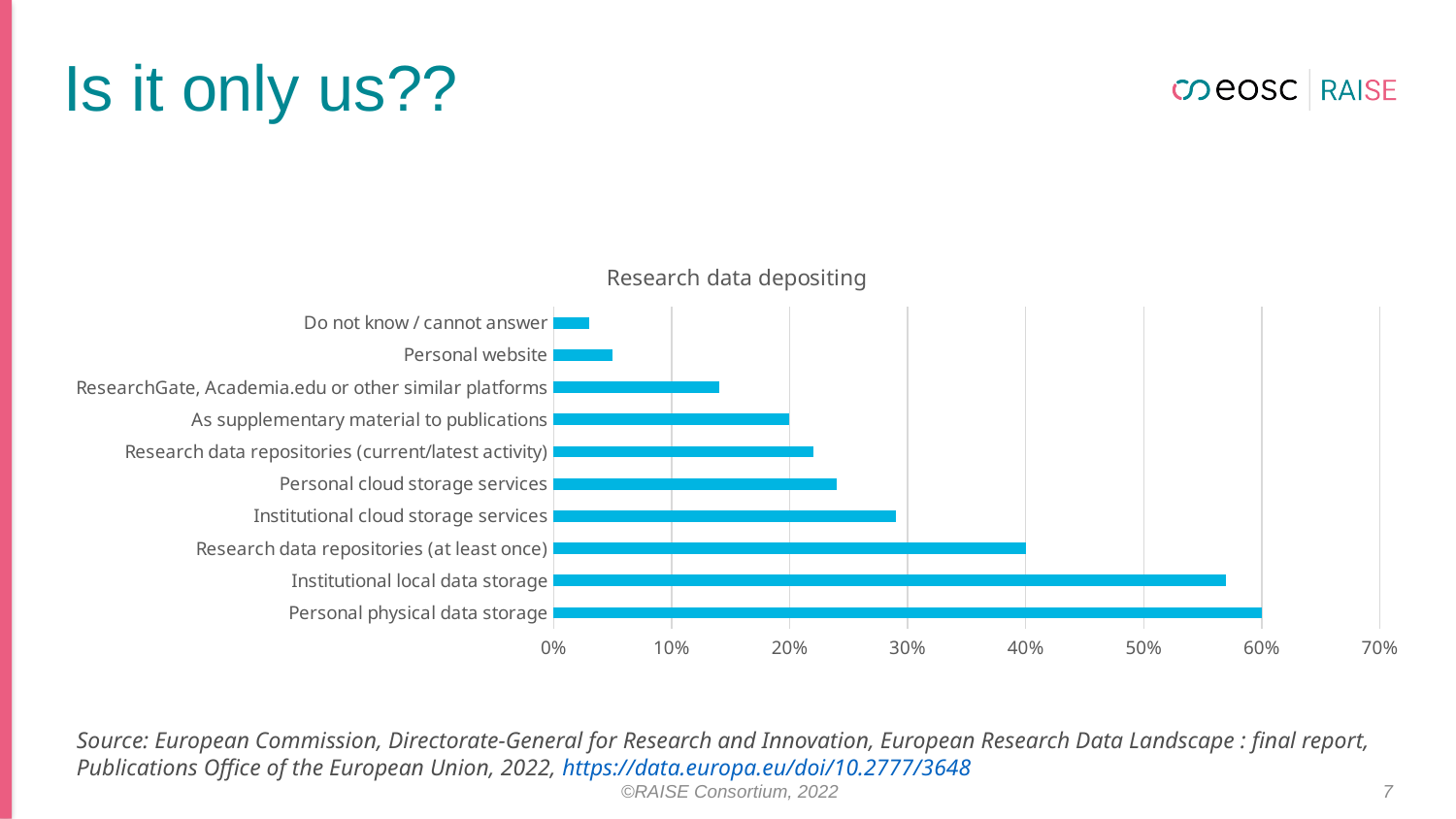
Which is larger: the value for Research data repositories (at least once) or the value for Research data repositories (current/latest activity)? Research data repositories (at least once) What is the title of the chart? Research data depositing Which category has the highest value? Personal physical data storage What type of chart is shown on the slide? Bar chart How many categories are plotted in the chart? 10 Is the value for Institutional local data storage greater or less than 50%? greater Is the value for ResearchGate, Academia.edu or other similar platforms greater or less than 20%? less Which category has the lowest value? Do not know / cannot answer Is the value for Personal website greater or less than 10%? less Which is larger: the value for Institutional cloud storage services or the value for Personal cloud storage services? Institutional cloud storage services